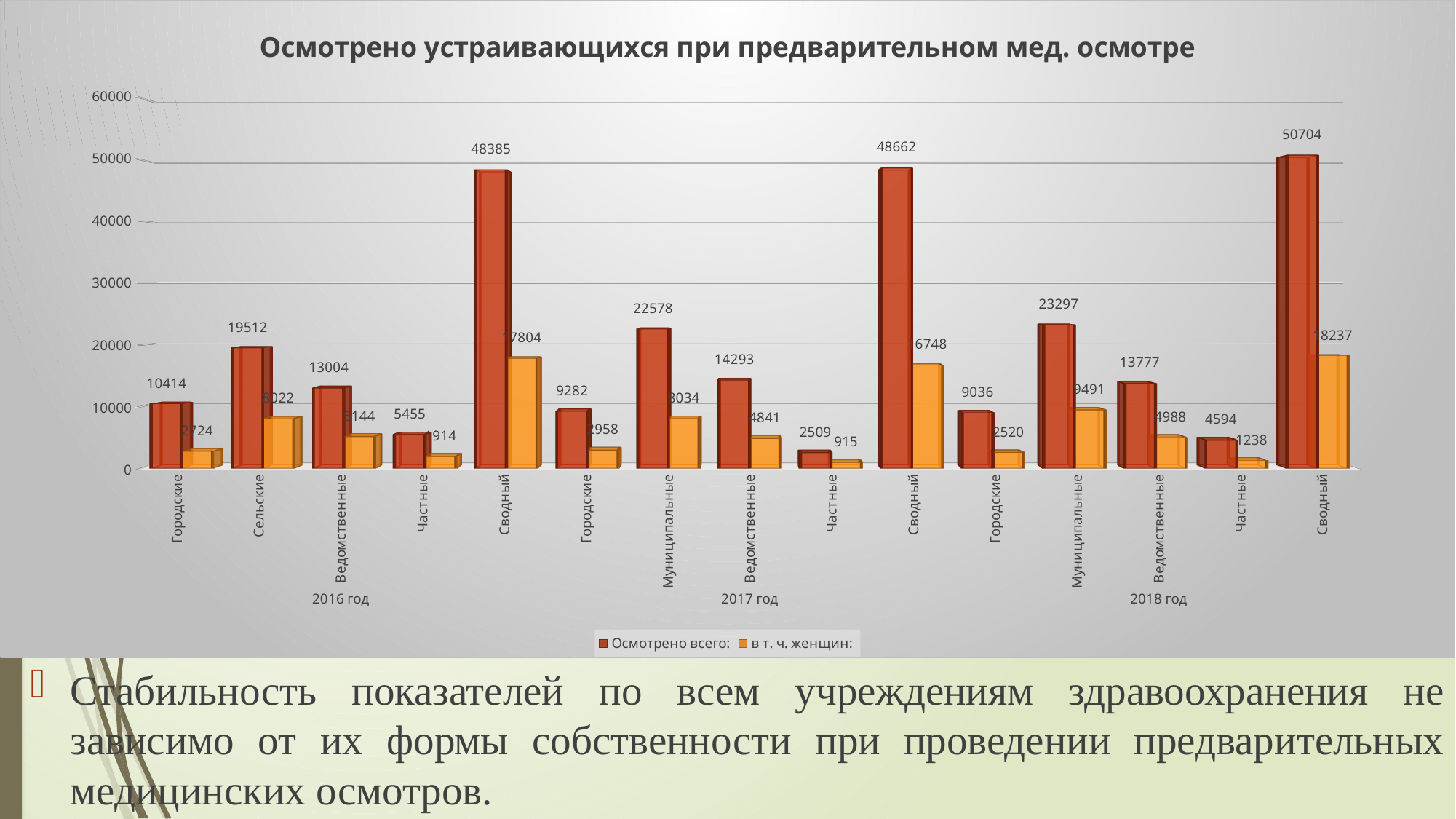
What is the value of 'в т. ч. женщин:' for Сводный in 2016 год? 17804 Which category and year has the highest 'Осмотрено всего:' value? Сводный, 2018 год Which is larger, the 'Осмотрено всего:' value for Муниципальные in 2017 год or in 2018 год? 2018 год What is the value of 'Осмотрено всего:' for Сводный in 2018 год? 50704 What is the value of 'Осмотрено всего:' for Частные in 2017 год? 2509 Is the 'Осмотрено всего:' value for Сельские in 2016 год greater or less than 20000? less How many year groups are shown on the x axis? 3 How many series does the legend list? 2 Which category and year has the lowest 'Осмотрено всего:' value? Частные, 2017 год What is the difference between the 'Осмотрено всего:' values for Сводный in 2018 год and Сводный in 2017 год? 2042 What is the difference between 'Осмотрено всего:' and 'в т. ч. женщин:' for Ведомственные in 2017 год? 9452 What kind of chart is shown on the slide? bar chart